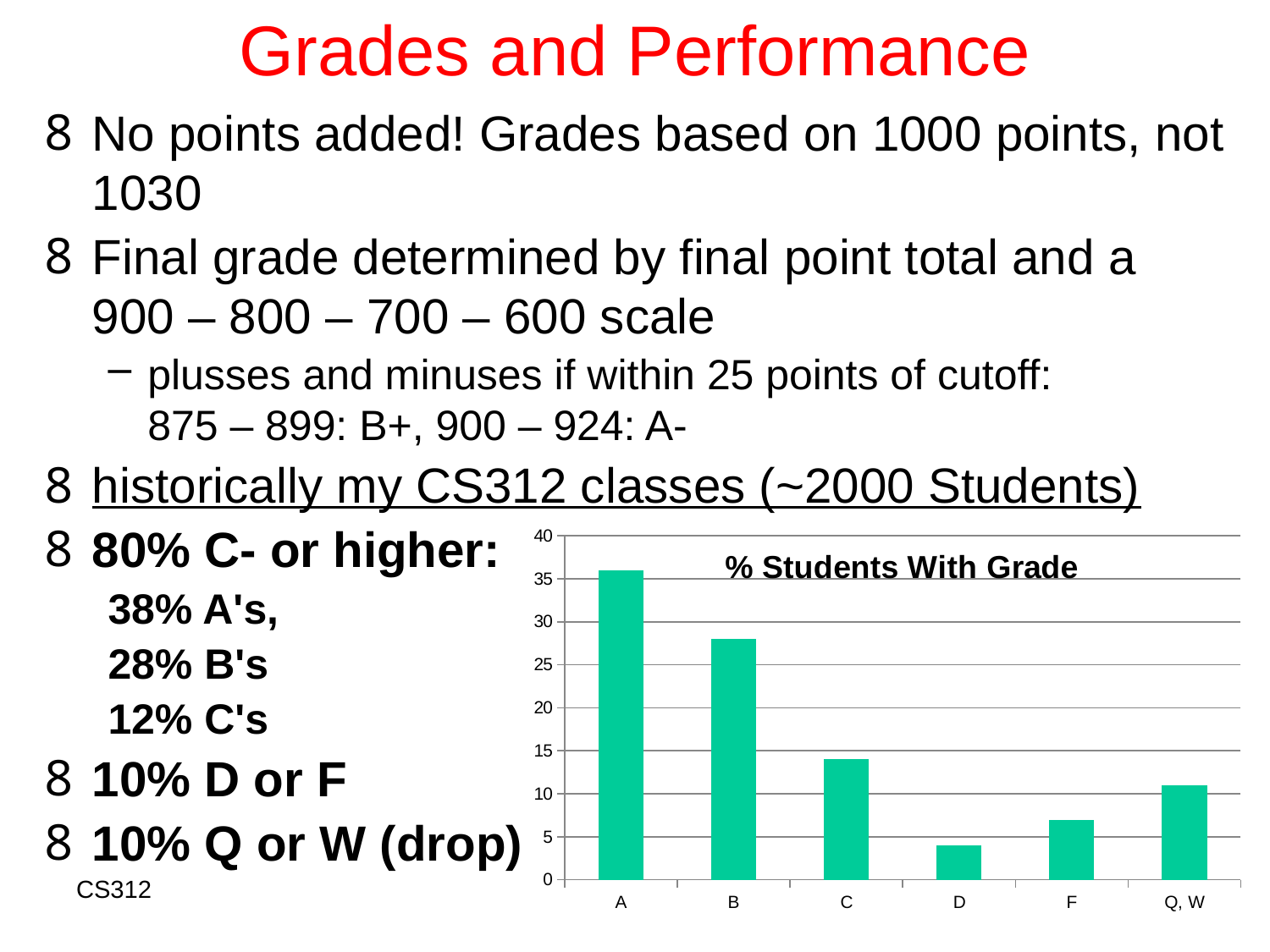
What is the title of the chart? % Students With Grade Is the value for B greater or less than 25? greater Is the value for Q, W greater or less than 10? greater How many grade categories are plotted on the x axis of the chart? 6 Is the value for D greater or less than 5? less Which grade category has the shortest bar in the chart? D Which is larger, the value for F or the value for Q, W? Q, W Which grade category has the tallest bar in the chart? A Do the bar values rise or fall from A to D along the x axis? fall What kind of chart is shown on the slide? bar chart